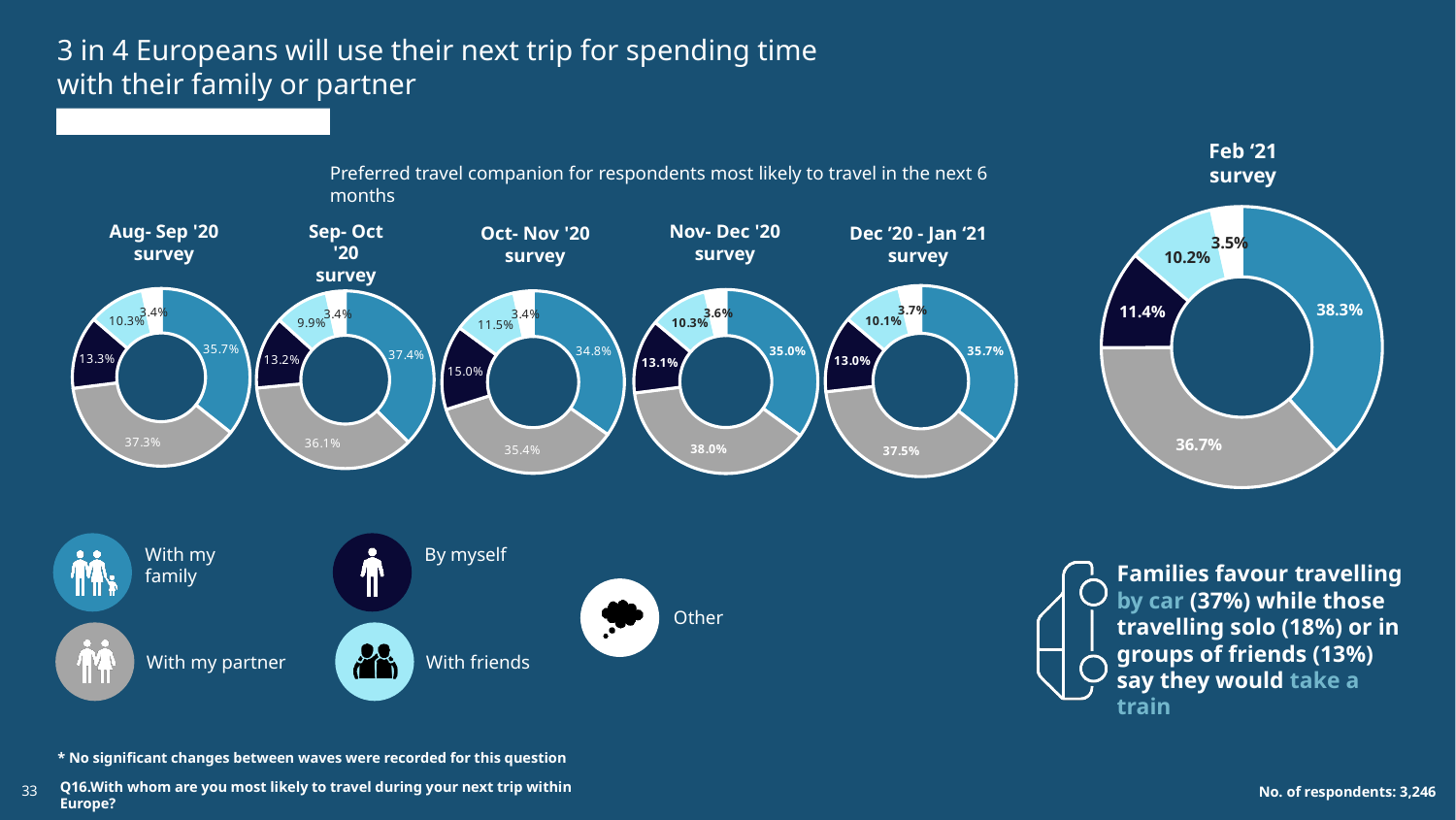
What type of chart is used to show the preferred travel companion for each survey wave? Donut (pie) chart In the Feb '21 survey chart, which travel companion has the smallest share? Other In the Feb '21 survey chart, what share of respondents said they would travel by themselves? 11.4% In the Feb '21 survey chart, what share of respondents said they would travel with their partner? 36.7% In the Feb '21 survey chart, what is the difference between the 'With my family' share and the 'With my partner' share? 1.6% In the Feb '21 survey chart, what share of respondents said they would travel with their family? 38.3% How many survey waves (donut charts) are shown on the slide? 6 In the Dec '20 - Jan '21 survey chart, what share of respondents said they would travel with friends? 10.1% In the Nov-Dec '20 survey chart, what share of respondents said they would travel with their partner? 38.0% In the Aug-Sep '20 survey chart, which is larger: the 'With my family' share or the 'With my partner' share? With my partner In the Feb '21 survey chart, which travel companion has the largest share? With my family In the Oct-Nov '20 survey chart, what share of respondents said they would travel by themselves? 15.0%